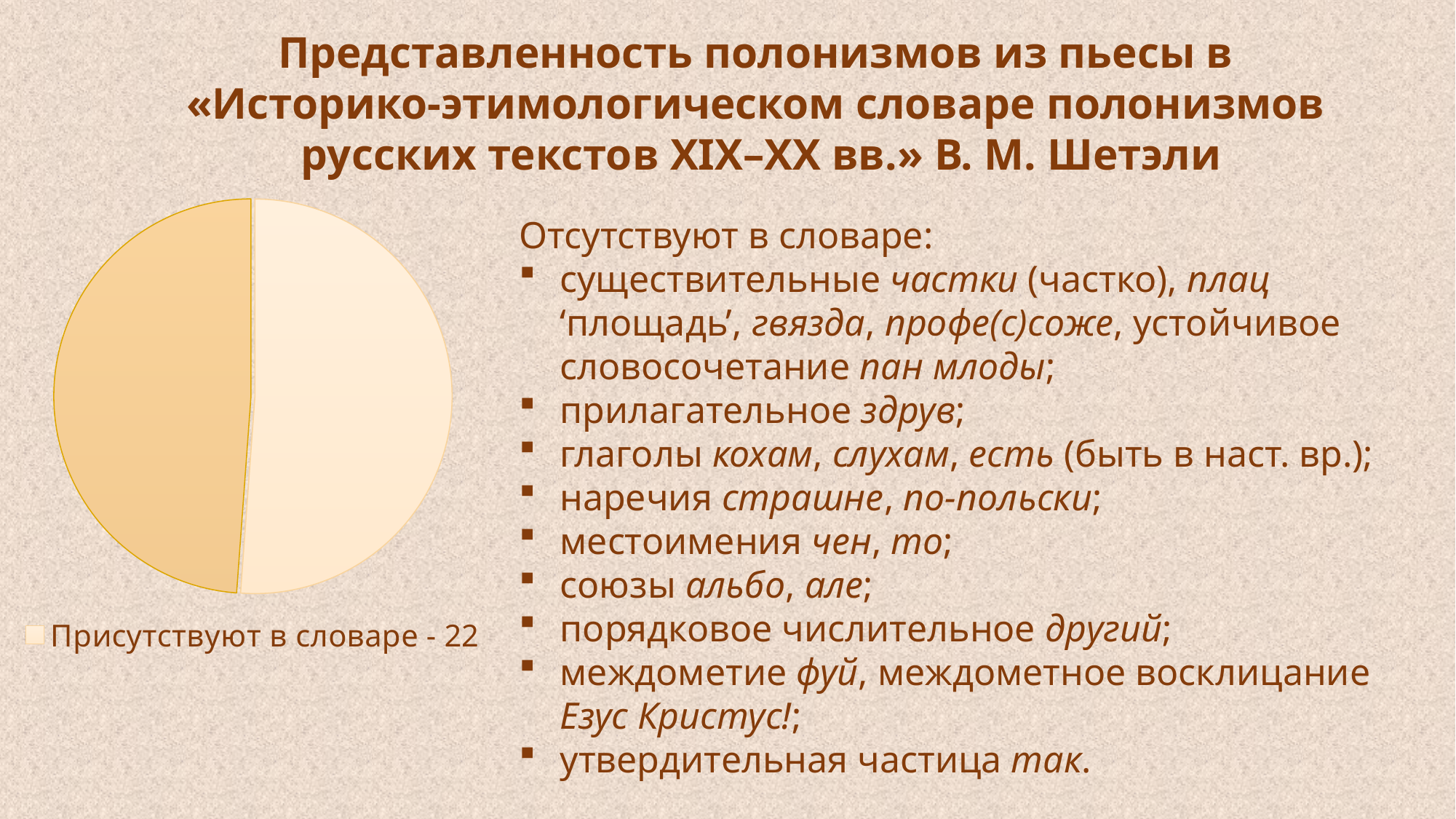
Which slice of the pie chart is labelled in the legend: the lighter cream slice or the darker orange slice? the lighter cream slice According to the legend, how many polonisms are present in the dictionary (Присутствуют в словаре)? 22 How many entries does the legend of the pie chart list? 1 What is the legend entry shown below the pie chart? Присутствуют в словаре - 22 What kind of chart is shown on the slide? pie chart How many slices does the pie chart have? 2